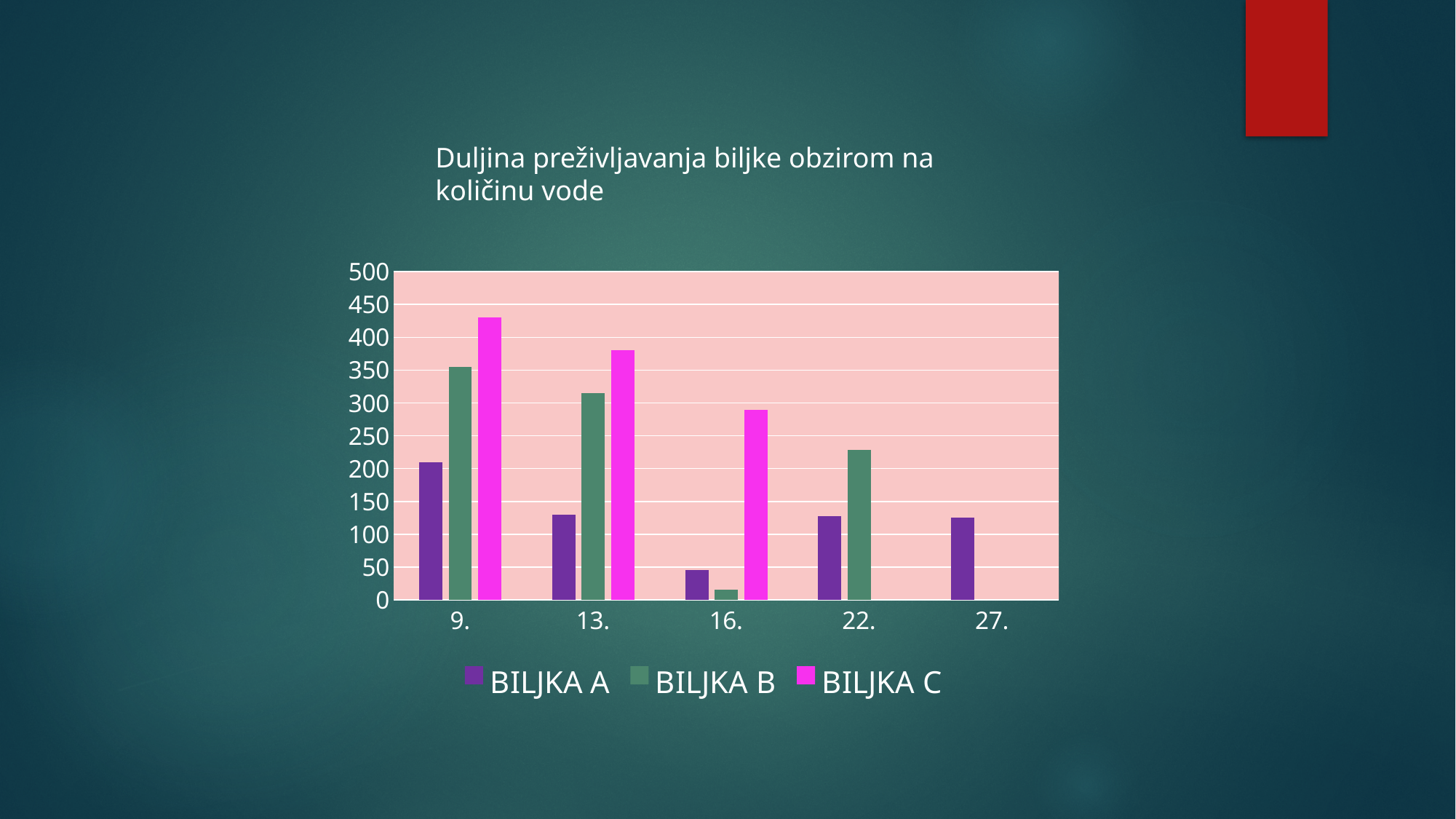
At category 22., which is larger, BILJKA A or BILJKA B? BILJKA B For which category is the BILJKA A bar lowest? 16. Do the BILJKA C values rise or fall from 9. to 16.? fall What is the title of the chart? Duljina preživljavanja biljke obzirom na količinu vode For which category is the BILJKA B bar lowest? 16. How many categories are shown on the x axis? 5 Is the value for BILJKA A at 9. greater or less than 250? less What kind of chart is shown on the slide? bar chart For which category is the BILJKA C bar highest? 9. How many series does the legend list? 3 Is the value for BILJKA C at 9. greater or less than 400? greater Is the value for BILJKA B at 13. greater or less than 300? greater